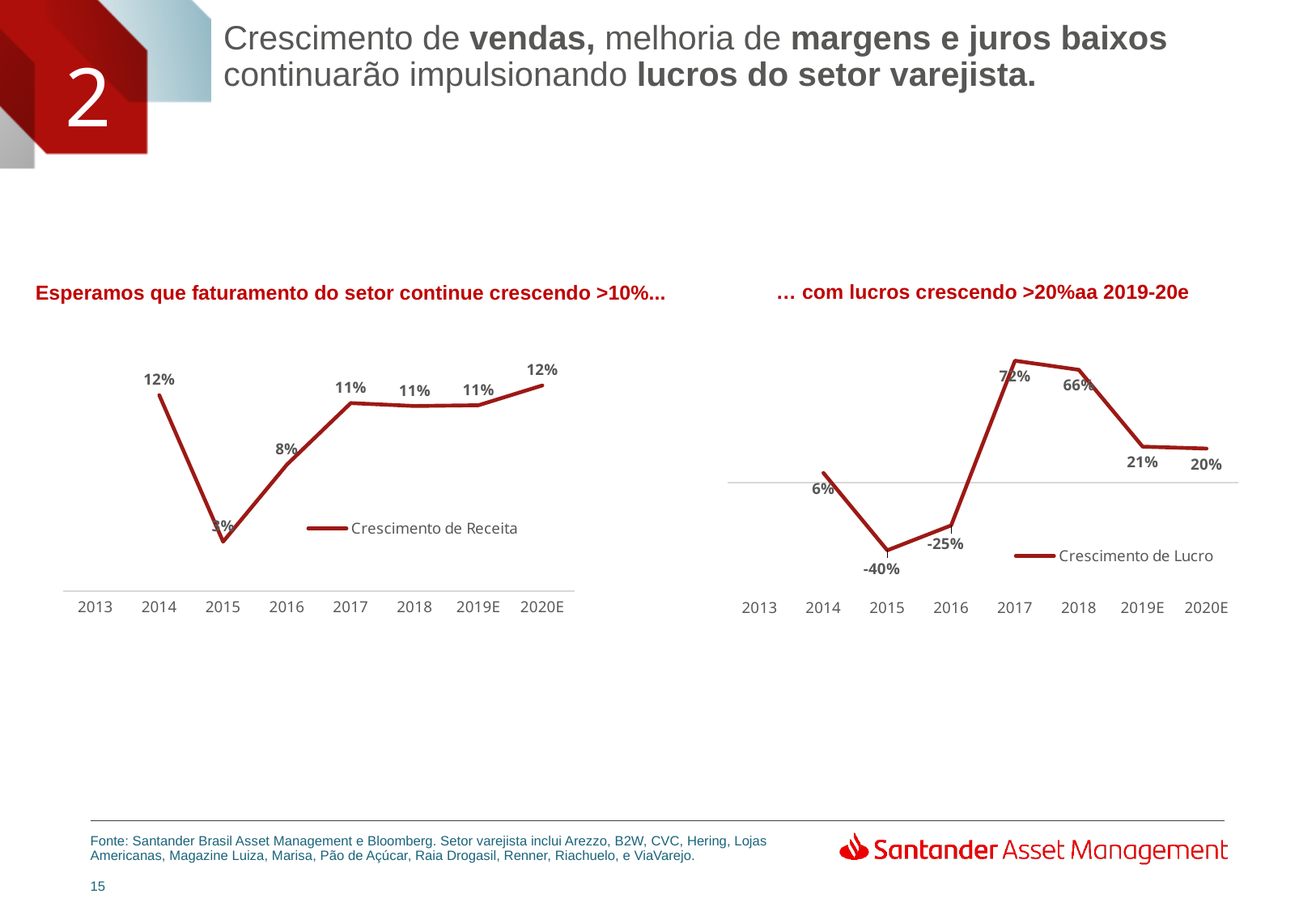
On the left chart (Crescimento de Receita), what is the value for 2016? 8% What type of chart is used on the left side of the slide? Line chart On the right chart (Crescimento de Lucro), what is the value for 2015? -40% What is the legend entry of the right chart? Crescimento de Lucro On the right chart (Crescimento de Lucro), which year has the highest value? 2017 On the right chart (Crescimento de Lucro), which is larger, the value for 2014 or the value for 2016? 2014 On the right chart (Crescimento de Lucro), which year has the lowest value? 2015 On the left chart (Crescimento de Receita), what is the difference between the 2017 value and the 2016 value? 3 percentage points On the right chart (Crescimento de Lucro), what is the value for 2019E? 21% On the left chart (Crescimento de Receita), what is the value for 2014? 12% On the right chart (Crescimento de Lucro), what is the difference between the 2018 value and the 2019E value? 45 percentage points On the left chart (Crescimento de Receita), what is the value for 2020E? 12%